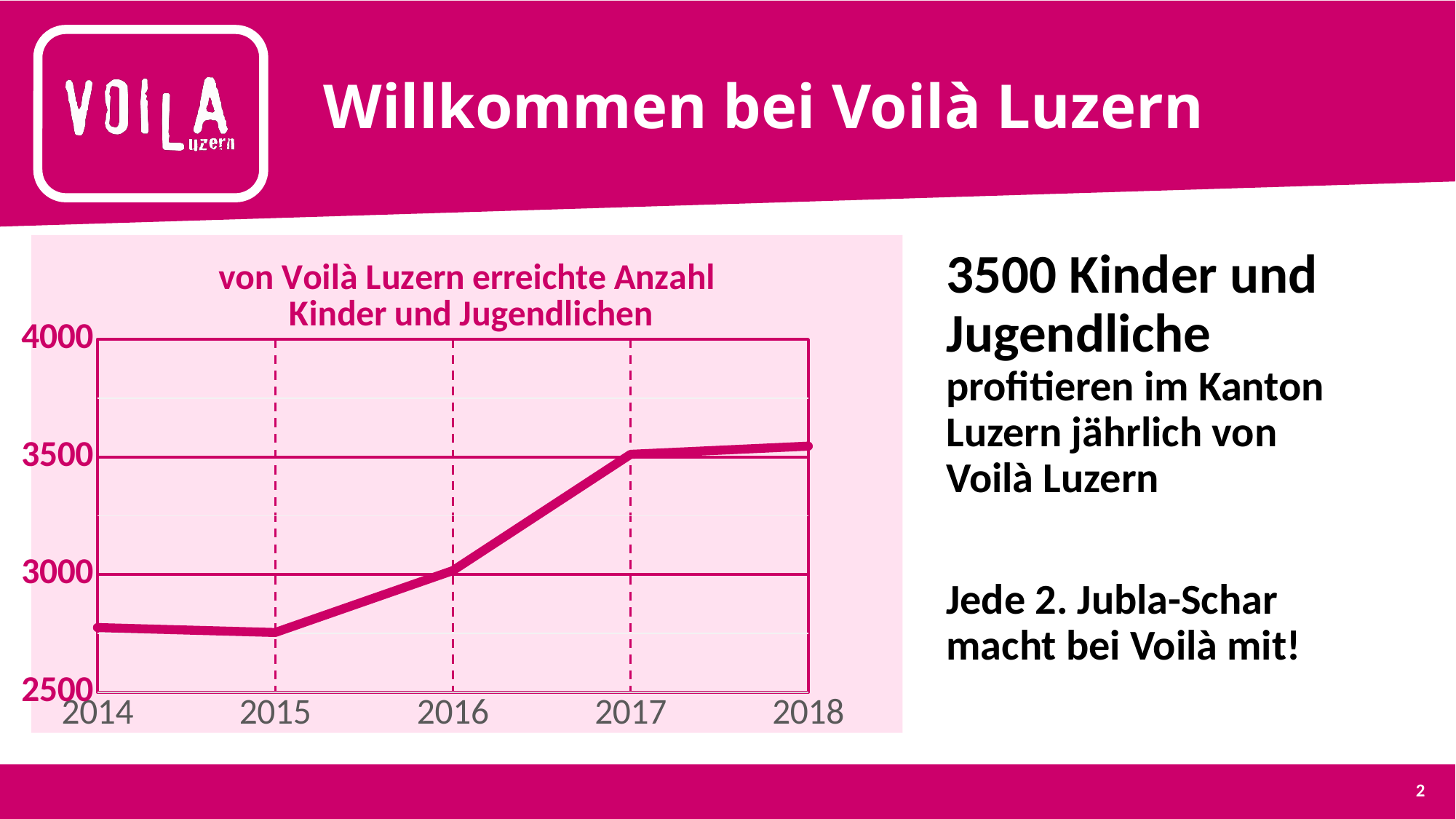
How many years are plotted on the x axis of the chart? 5 Which is larger, the value for 2017 or the value for 2015? 2017 Is the value for 2018 greater or less than 4000? less Do the values generally rise or fall from 2015 to 2018? rise What is the lowest value shown on the y axis of the chart? 2500 Is the value for 2014 greater or less than 3000? less Is the value for 2018 greater or less than 3500? greater What is the title of the chart? von Voilà Luzern erreichte Anzahl Kinder und Jugendlichen What kind of chart is shown on the slide? line chart Which year has the highest value in the chart? 2018